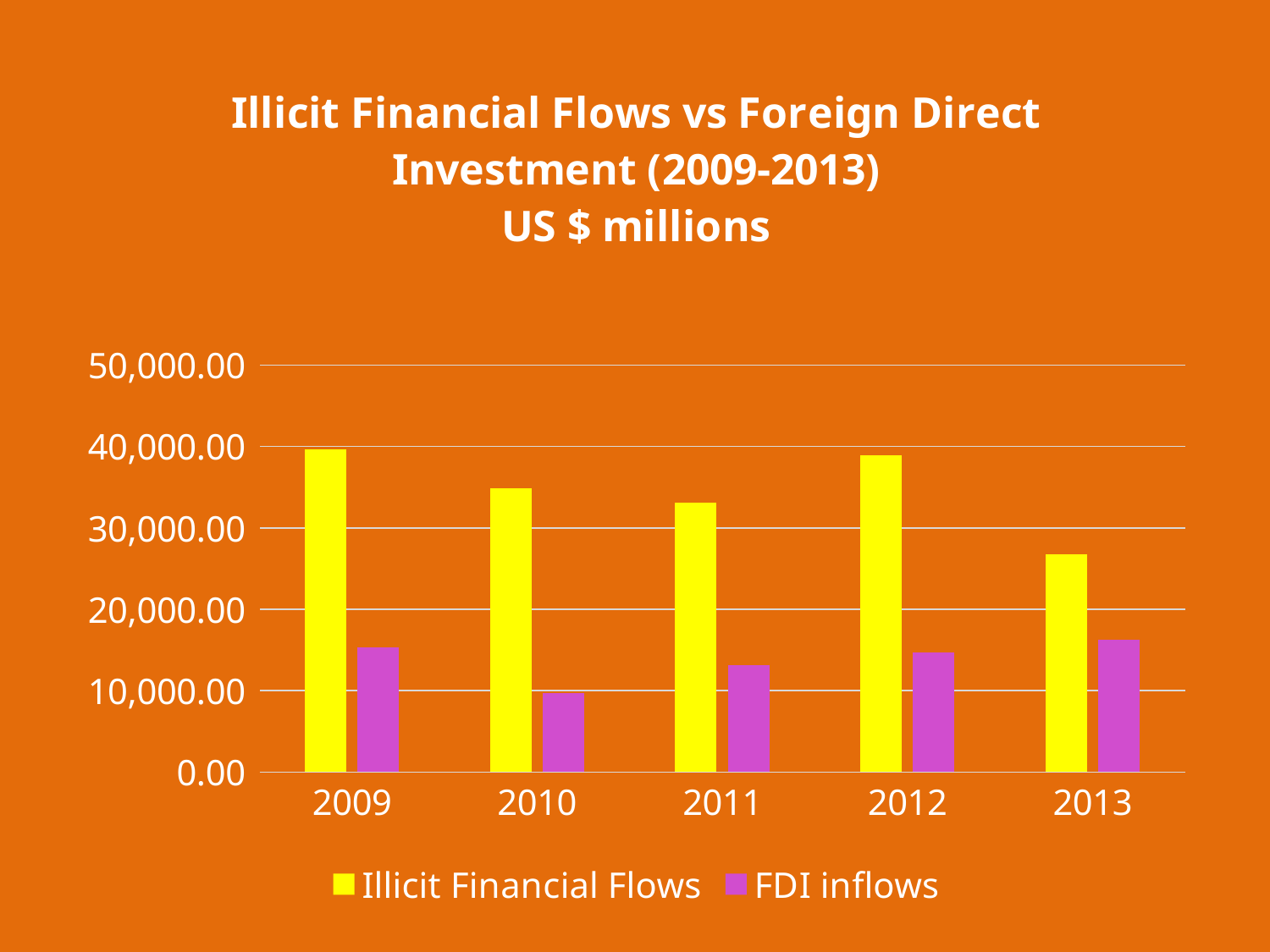
In 2009, which is larger: Illicit Financial Flows or FDI inflows? Illicit Financial Flows How many series does the legend list? 2 Is the value for Illicit Financial Flows in 2013 greater or less than 30,000.00? less Which colour represents FDI inflows in the chart? purple How many years are shown on the x axis? 5 Which year has the lowest value for FDI inflows? 2010 Which year has the lowest value for Illicit Financial Flows? 2013 Is the value for FDI inflows in 2013 greater or less than 20,000.00? less What kind of chart is shown on the slide? bar chart Do Illicit Financial Flows rise or fall from 2012 to 2013? fall Is the value for FDI inflows in 2012 greater or less than 10,000.00? greater